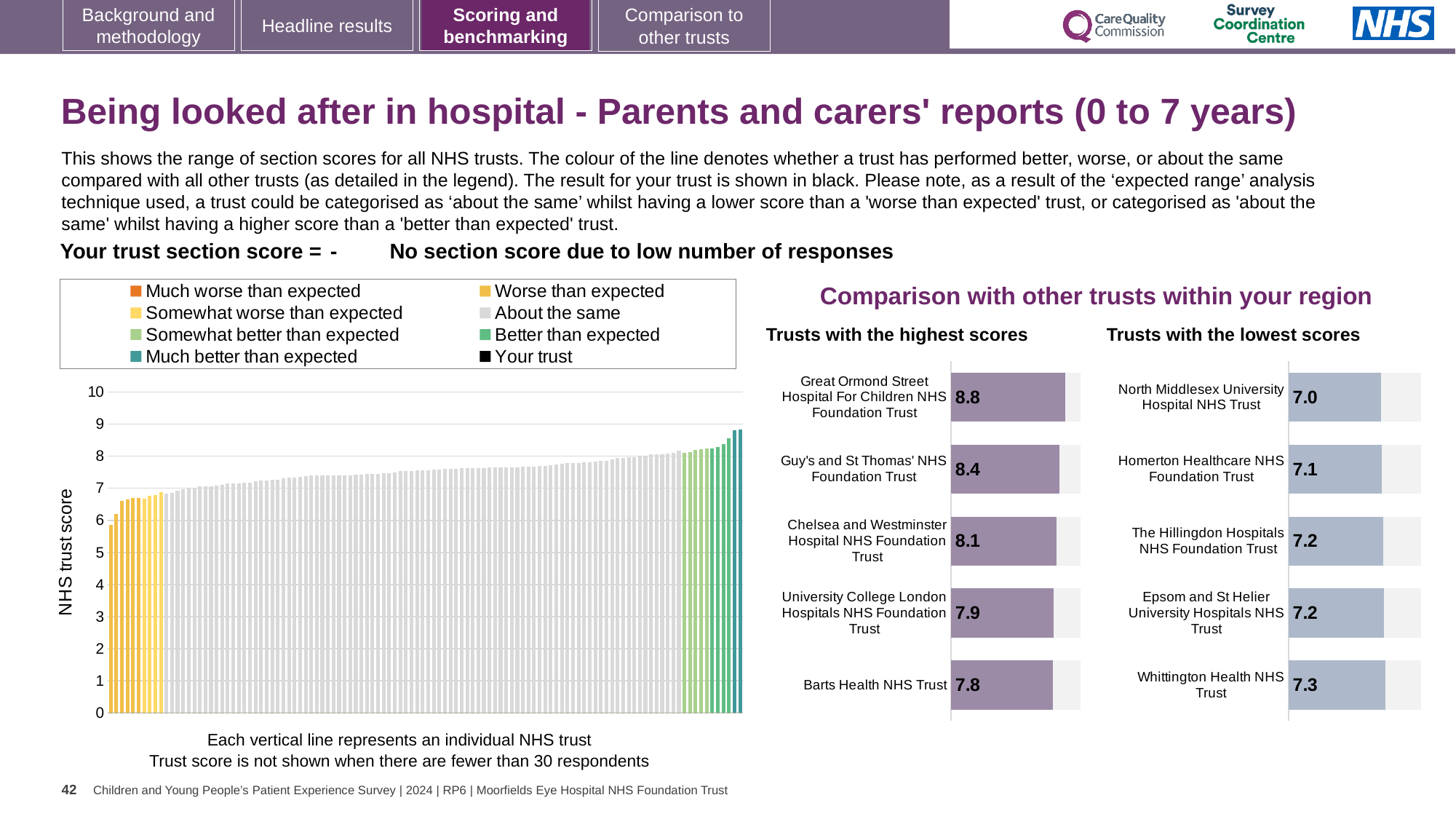
In the 'Trusts with the highest scores' chart, which has the higher score: Guy's and St Thomas' NHS Foundation Trust or University College London Hospitals NHS Foundation Trust? Guy's and St Thomas' NHS Foundation Trust What kind of chart is the NHS trust score chart on the left of the slide? Bar chart In the 'Trusts with the highest scores' chart, which trust has the lowest score shown? Barts Health NHS Trust How many trusts are listed in the 'Trusts with the lowest scores' chart? 5 How many entries does the legend of the NHS trust score chart list? 8 In the 'Trusts with the lowest scores' chart, what is the difference between the scores of Whittington Health NHS Trust and North Middlesex University Hospital NHS Trust? 0.3 In the 'Trusts with the highest scores' chart, what is the score for Great Ormond Street Hospital For Children NHS Foundation Trust? 8.8 In the 'Trusts with the lowest scores' chart, which trust has the lowest score? North Middlesex University Hospital NHS Trust In the NHS trust score chart on the left, do the values rise or fall from left to right? Rise In the 'Trusts with the lowest scores' chart, what is the score for Homerton Healthcare NHS Foundation Trust? 7.1 In the 'Trusts with the highest scores' chart, what is the difference between the scores of Great Ormond Street Hospital For Children NHS Foundation Trust and Barts Health NHS Trust? 1.0 In the NHS trust score chart on the left, is the value of the tallest bar greater or less than 8? greater